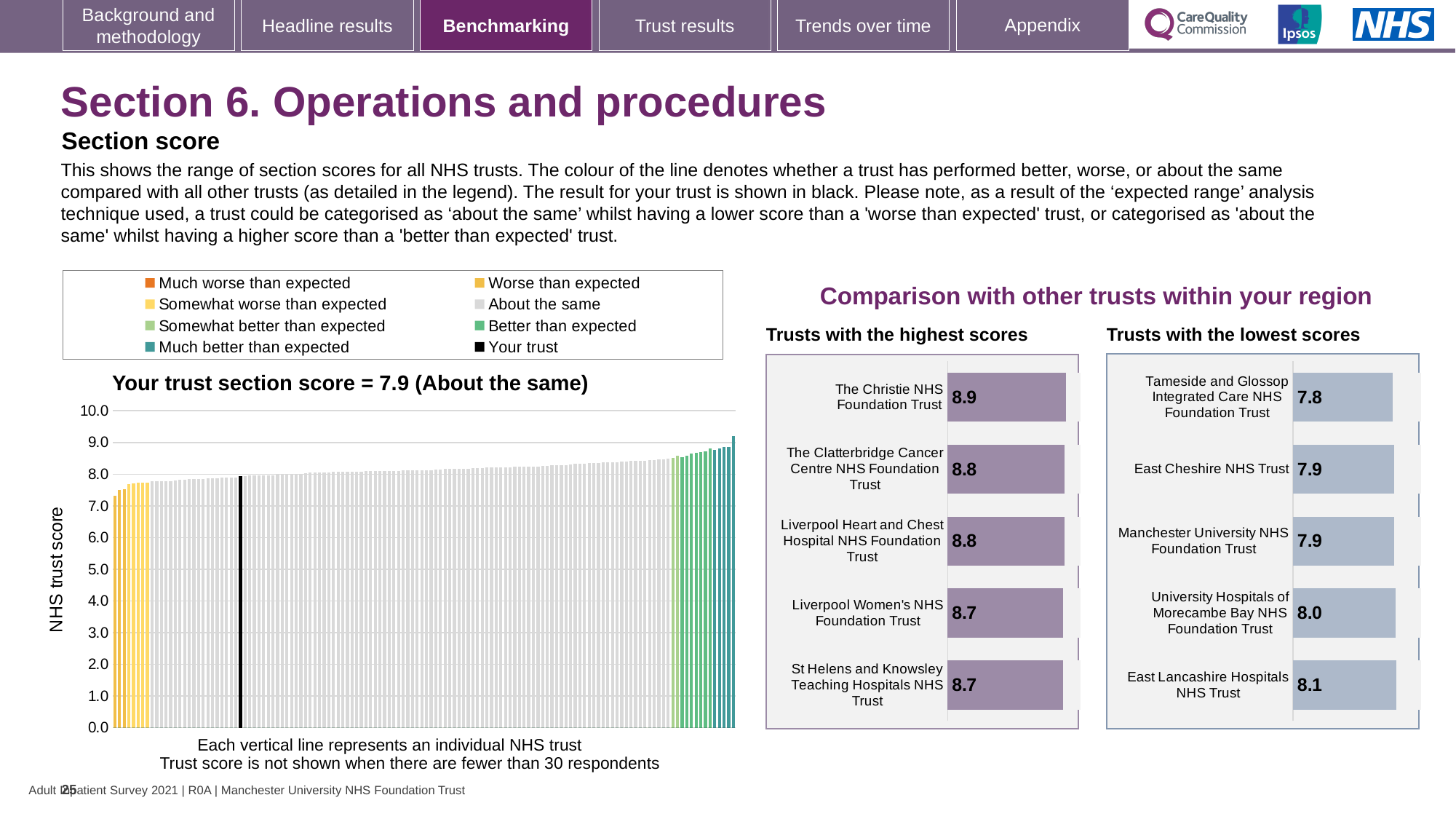
On the 'Your trust section score' chart, which category does your trust fall into? About the same On the 'Your trust section score' chart, what is the section score for your trust? 7.9 On the 'Your trust section score' chart, is the value of the leftmost (lowest) bar greater or less than 8.0? less On the 'Your trust section score' chart, do the trust scores rise or fall from left to right along the x axis? rise On the 'Trusts with the highest scores' chart, what is the difference between the scores of The Christie NHS Foundation Trust and Liverpool Women's NHS Foundation Trust? 0.2 On the 'Trusts with the lowest scores' chart, which trust has the lowest score? Tameside and Glossop Integrated Care NHS Foundation Trust On the 'Trusts with the highest scores' chart, what is the score for The Christie NHS Foundation Trust? 8.9 On the 'Trusts with the lowest scores' chart, which has the larger score: University Hospitals of Morecambe Bay NHS Foundation Trust or Tameside and Glossop Integrated Care NHS Foundation Trust? University Hospitals of Morecambe Bay NHS Foundation Trust What kind of chart is the 'Your trust section score' chart? bar chart How many entries does the legend above the 'Your trust section score' chart list? 8 On the 'Trusts with the highest scores' chart, which trust has the highest score? The Christie NHS Foundation Trust How many trusts are shown on the 'Trusts with the lowest scores' chart? 5